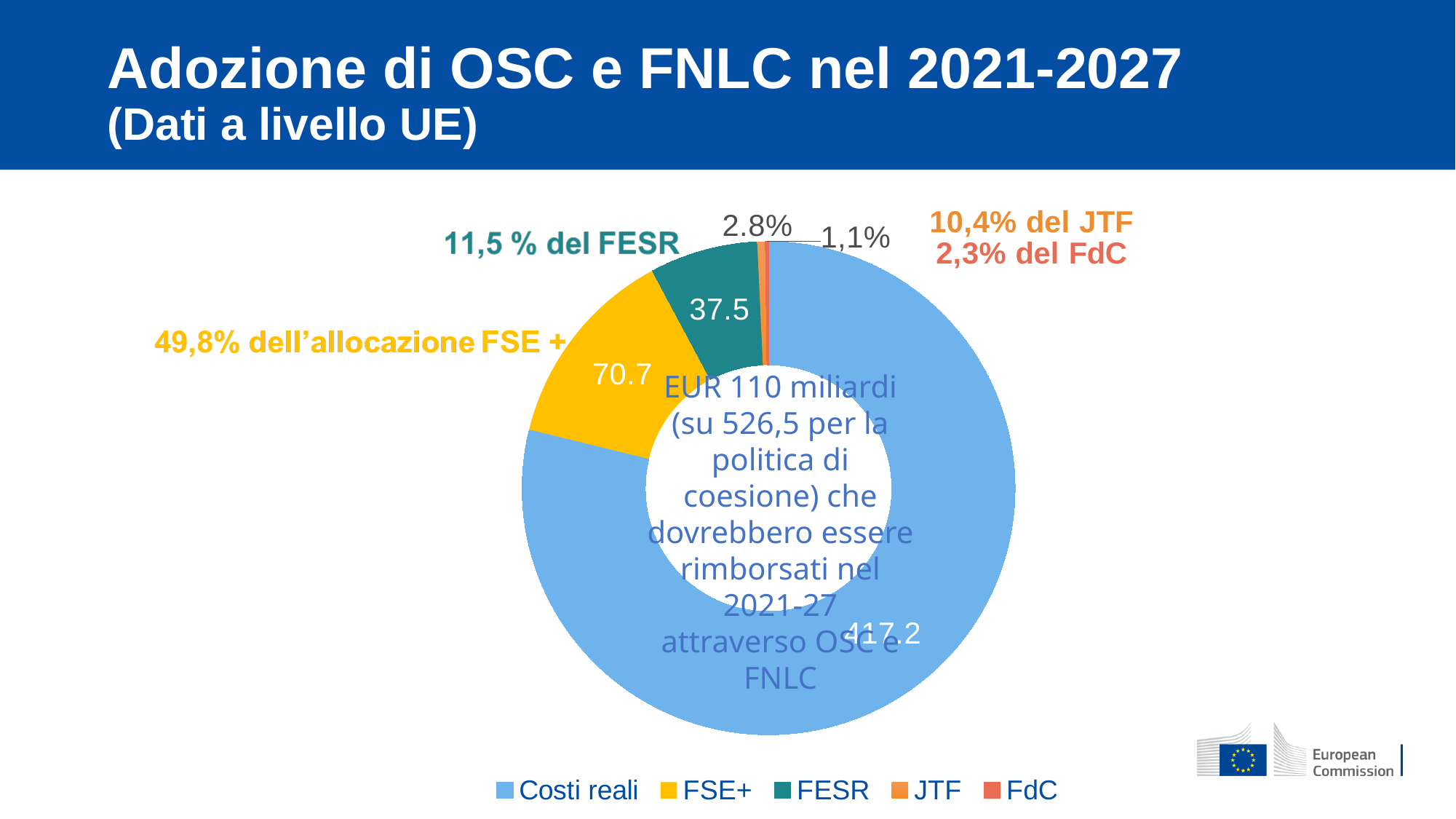
Which is larger in the chart, FSE+ or FESR? FSE+ Which category has the smallest slice in the chart? FdC Which category has the largest slice in the chart? Costi reali What is the value shown for FSE+ in the chart? 70.7 How many categories does the legend of the chart list? 5 What label is shown on the JTF slice of the chart? 2.8% What is the difference between the values for FSE+ and FESR? 33.2 What is the value shown for Costi reali in the chart? 417.2 What kind of chart is shown on the slide? doughnut (pie) chart What is the difference between the values for Costi reali and FSE+? 346.5 What total amount in EUR is stated in the centre of the doughnut chart? EUR 110 miliardi What is the value shown for FESR in the chart? 37.5